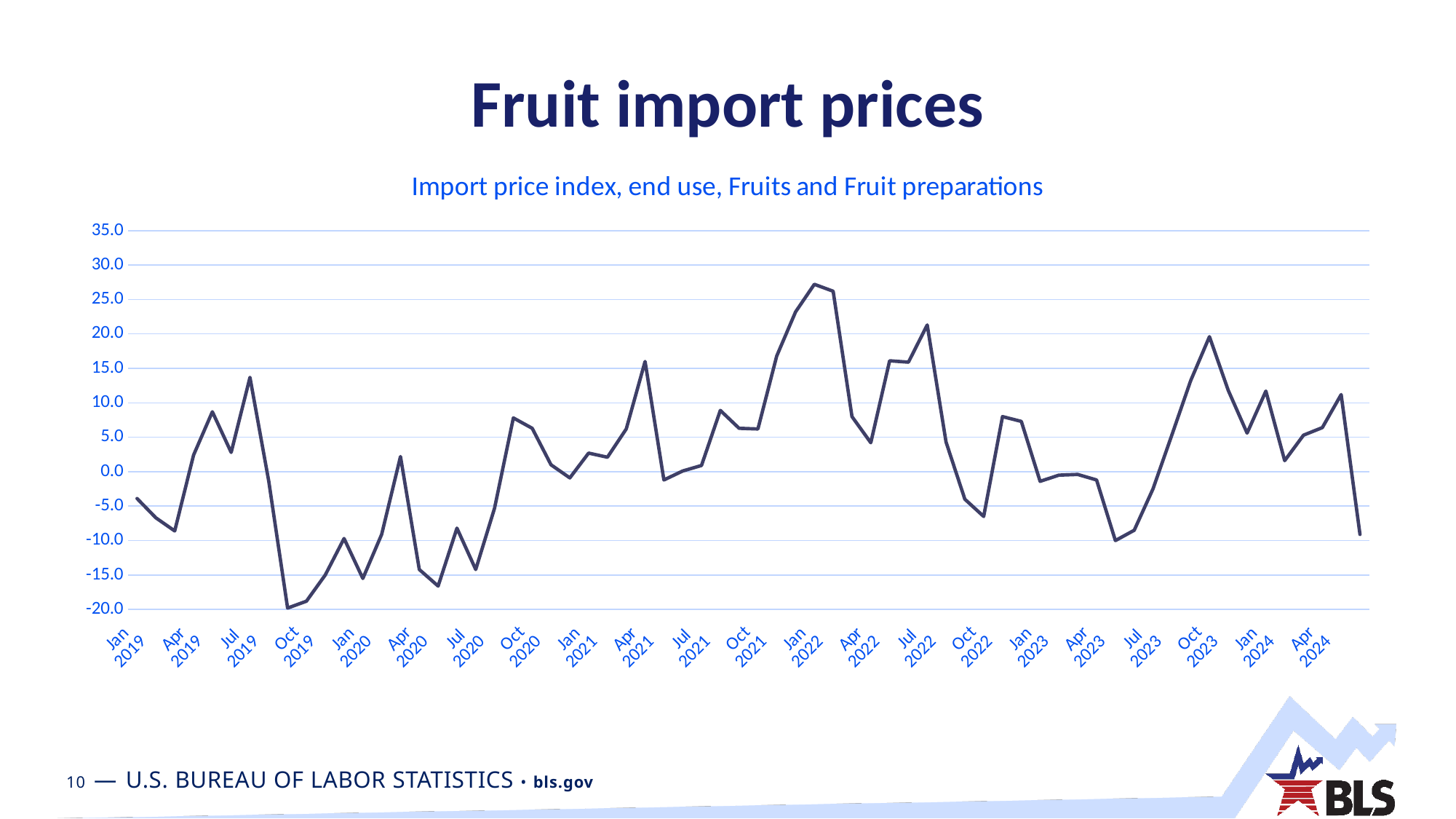
Is the value for Jan 2019 greater or less than 0.0? less What is the subtitle shown above the chart? Import price index, end use, Fruits and Fruit preparations Is the value for Jul 2023 greater or less than -5.0? greater Around which x-axis label does the line reach its highest value? Jan 2022 Is the value for Oct 2019 greater or less than -15.0? less Around which x-axis label does the line reach its lowest value? Oct 2019 Does the line rise or fall between Jan 2022 and Oct 2022? fall What is the title of the chart on the slide? Fruit import prices Which is larger, the value for Jan 2022 or the value for Oct 2019? Jan 2022 What kind of chart is shown on the slide? line chart